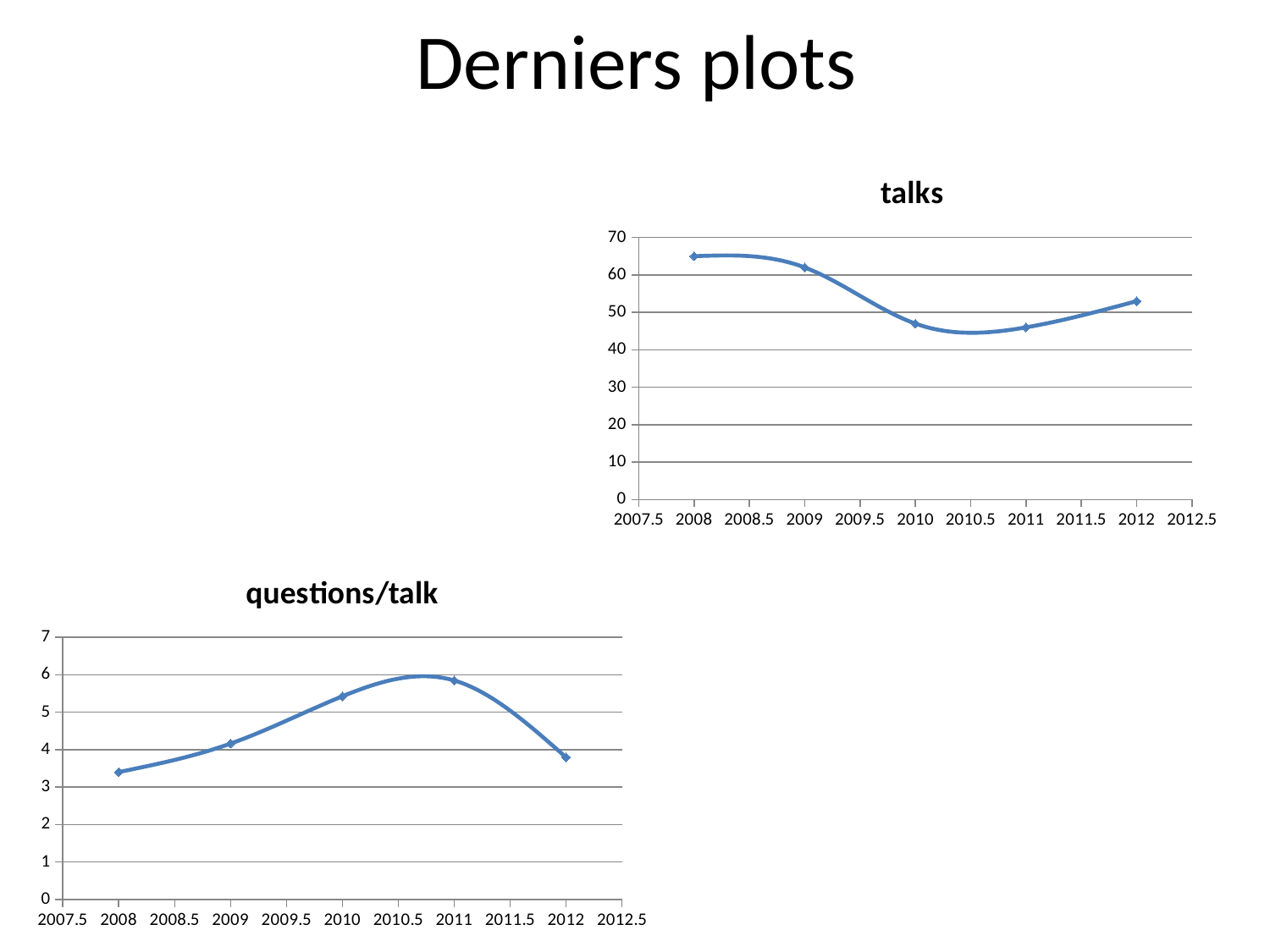
On the 'talks' chart, is the value for 2010 greater or less than 50? less On the 'questions/talk' chart, which year has the highest value? 2011 What kind of chart is the 'talks' chart? line chart On the 'talks' chart, which is larger, the value for 2009 or the value for 2010? 2009 On the 'talks' chart, do the values rise or fall from 2008 to 2010? fall How many data points are plotted on the 'talks' chart? 5 On the 'talks' chart, is the value for 2008 greater or less than 60? greater On the 'talks' chart, which year has the highest value? 2008 What is the title of the chart in the bottom left of the slide? questions/talk On the 'questions/talk' chart, is the value for 2010 greater or less than 5? greater How many data points are plotted on the 'questions/talk' chart? 5 On the 'questions/talk' chart, do the values rise or fall from 2008 to 2011? rise